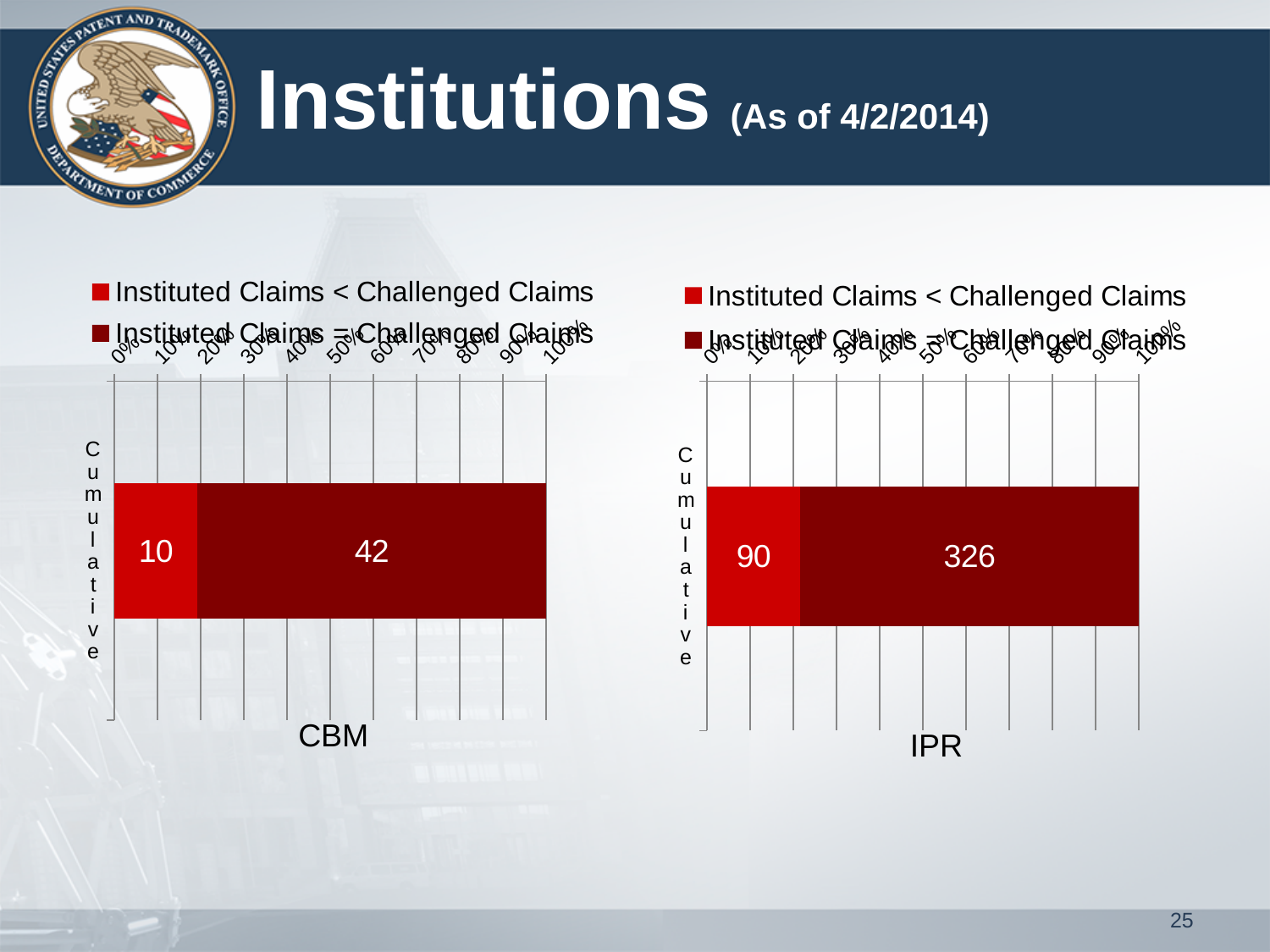
On the IPR chart, what value is shown for the 'Instituted Claims = Challenged Claims' segment? 326 What kind of chart is the CBM chart? Stacked bar chart On the CBM chart, which segment is larger: 'Instituted Claims < Challenged Claims' or 'Instituted Claims = Challenged Claims'? Instituted Claims = Challenged Claims On the CBM chart, what is the total of the two segments in the stacked bar? 52 On the CBM chart, what is the difference between the two segment values? 32 On the CBM chart, what value is shown for the 'Instituted Claims = Challenged Claims' segment? 42 How many series does the legend of the IPR chart list? 2 On the IPR chart, what is the total of the two segments in the stacked bar? 416 On the IPR chart, what is the difference between the 'Instituted Claims = Challenged Claims' value and the 'Instituted Claims < Challenged Claims' value? 236 On the IPR chart, what value is shown for the 'Instituted Claims < Challenged Claims' segment? 90 On the CBM chart, what value is shown for the 'Instituted Claims < Challenged Claims' segment? 10 What is the y-axis label on the IPR chart? Cumulative